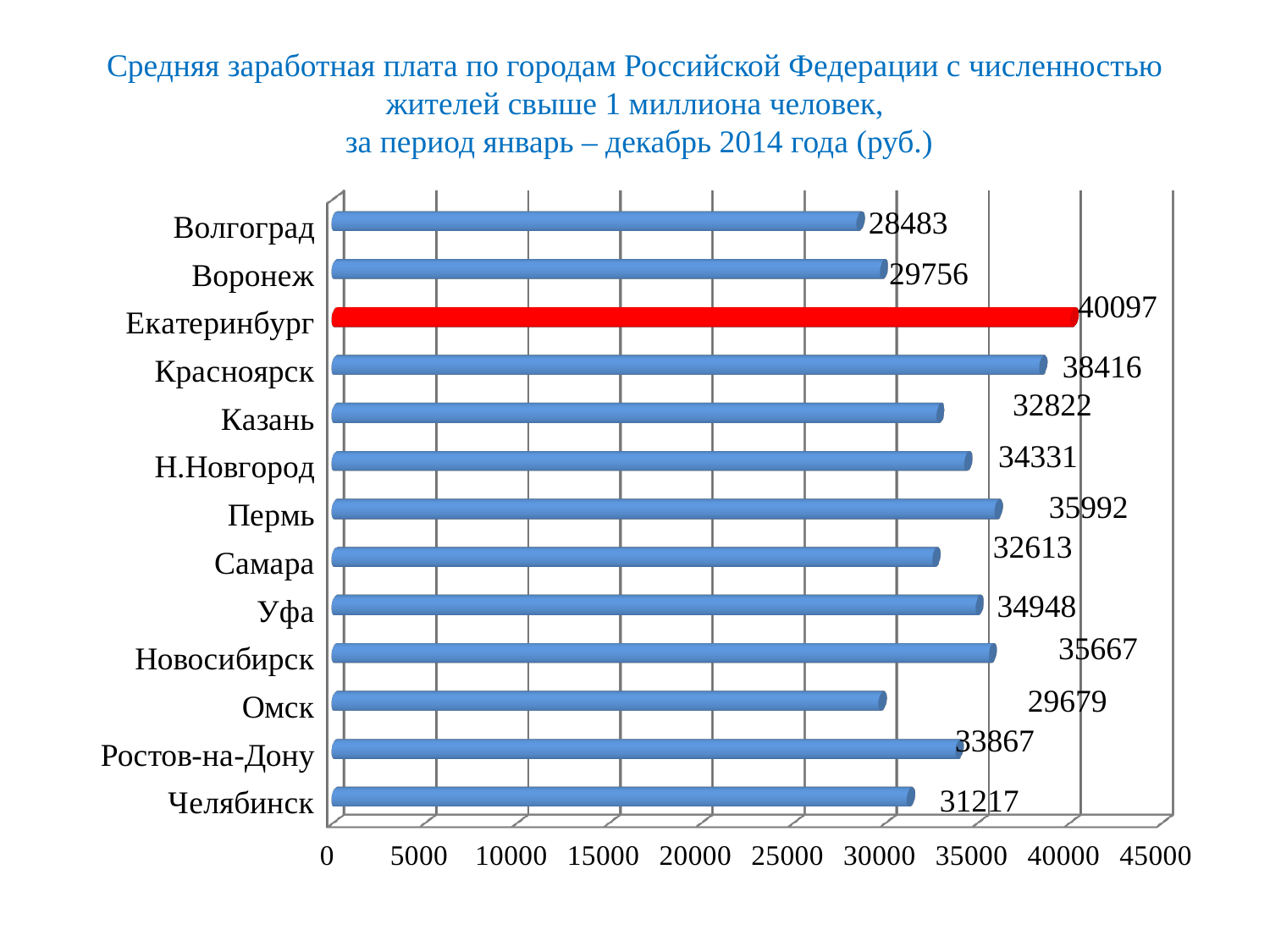
Which city has the lowest average salary on the chart? Волгоград Which has a larger value, Пермь or Новосибирск? Пермь What value is shown for Челябинск? 31217 Is the value for Омск greater or less than 30000? less Which has a larger value, Уфа or Самара? Уфа What is the average salary shown for Екатеринбург? 40097 What kind of chart is shown on the slide? bar chart How many cities are shown on the chart? 13 Which city has the highest average salary on the chart? Екатеринбург What is the difference between the values for Воронеж and Волгоград? 1273 What is the value for Ростов-на-Дону? 33867 What is the difference between the values for Екатеринбург and Красноярск? 1681